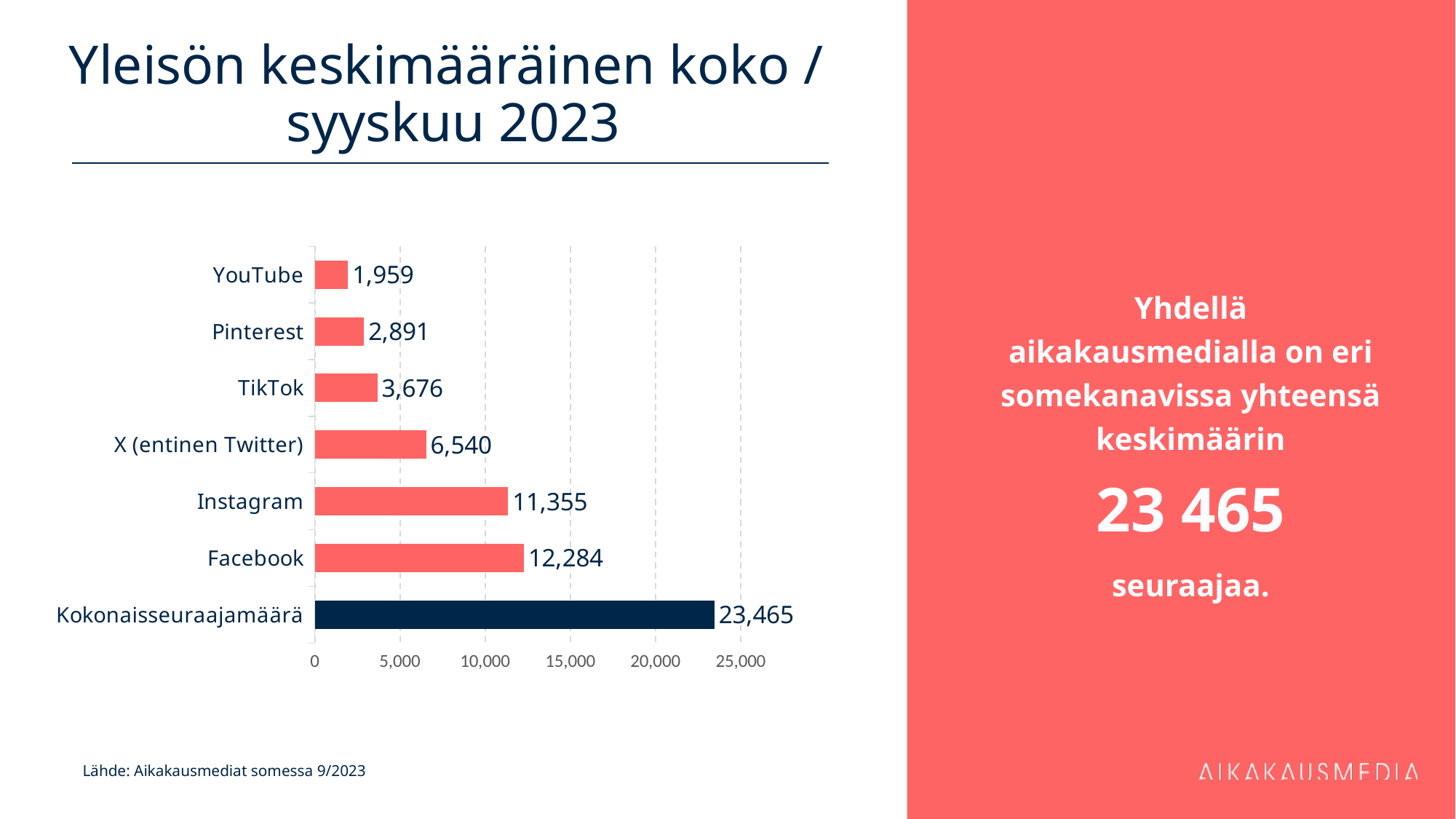
Which individual social media channel (excluding the total bar) has the highest value? Facebook Which is larger, the value for TikTok or the value for Pinterest? TikTok Is the value for X (entinen Twitter) greater or less than 5,000? greater What is the difference between the values for Facebook and Instagram? 929 What kind of chart is shown on the slide? Bar chart What is the value for Instagram? 11,355 What is the value for Kokonaisseuraajamäärä? 23,465 Which category has the lowest value? YouTube What is the difference between the values for TikTok and Pinterest? 785 What is the value for X (entinen Twitter)? 6,540 Which category has the highest value? Kokonaisseuraajamäärä How many categories are shown in the chart? 7